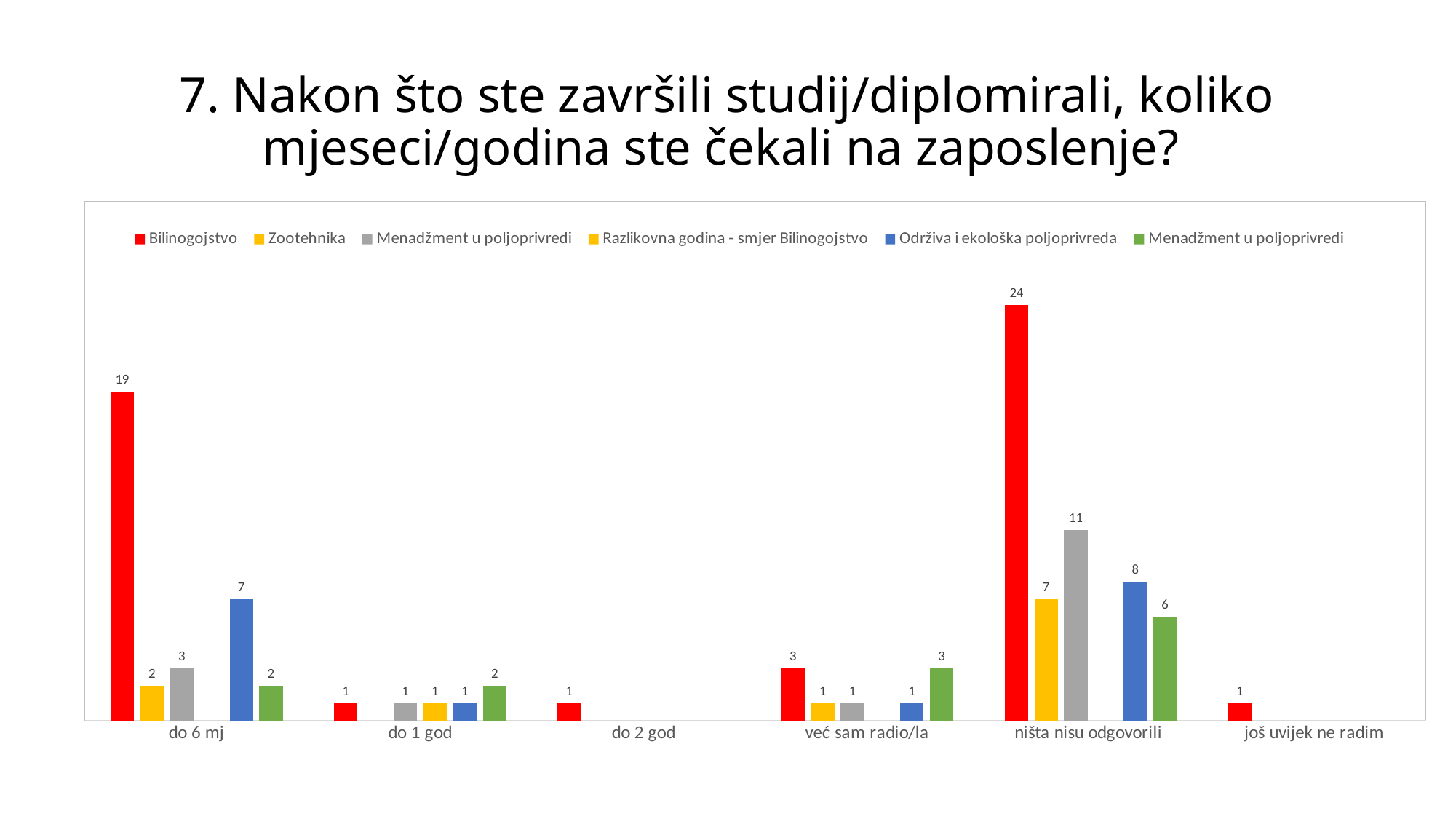
In which category does Bilinogojstvo have its highest value? ništa nisu odgovorili What is the value for Održiva i ekološka poljoprivreda in the "do 6 mj" category? 7 What is the value for Bilinogojstvo in the "do 6 mj" category? 19 What is the difference between the Bilinogojstvo values for "ništa nisu odgovorili" and "do 6 mj"? 5 How many series does the legend list? 6 How many categories are shown on the x axis? 6 What is the value for Održiva i ekološka poljoprivreda in the "ništa nisu odgovorili" category? 8 What is the value for Bilinogojstvo in the "već sam radio/la" category? 3 What is the value for Bilinogojstvo in the "ništa nisu odgovorili" category? 24 What colour represents the Bilinogojstvo series? red What kind of chart is shown on the slide? bar chart In the "do 6 mj" category, which is larger: Bilinogojstvo or Održiva i ekološka poljoprivreda? Bilinogojstvo